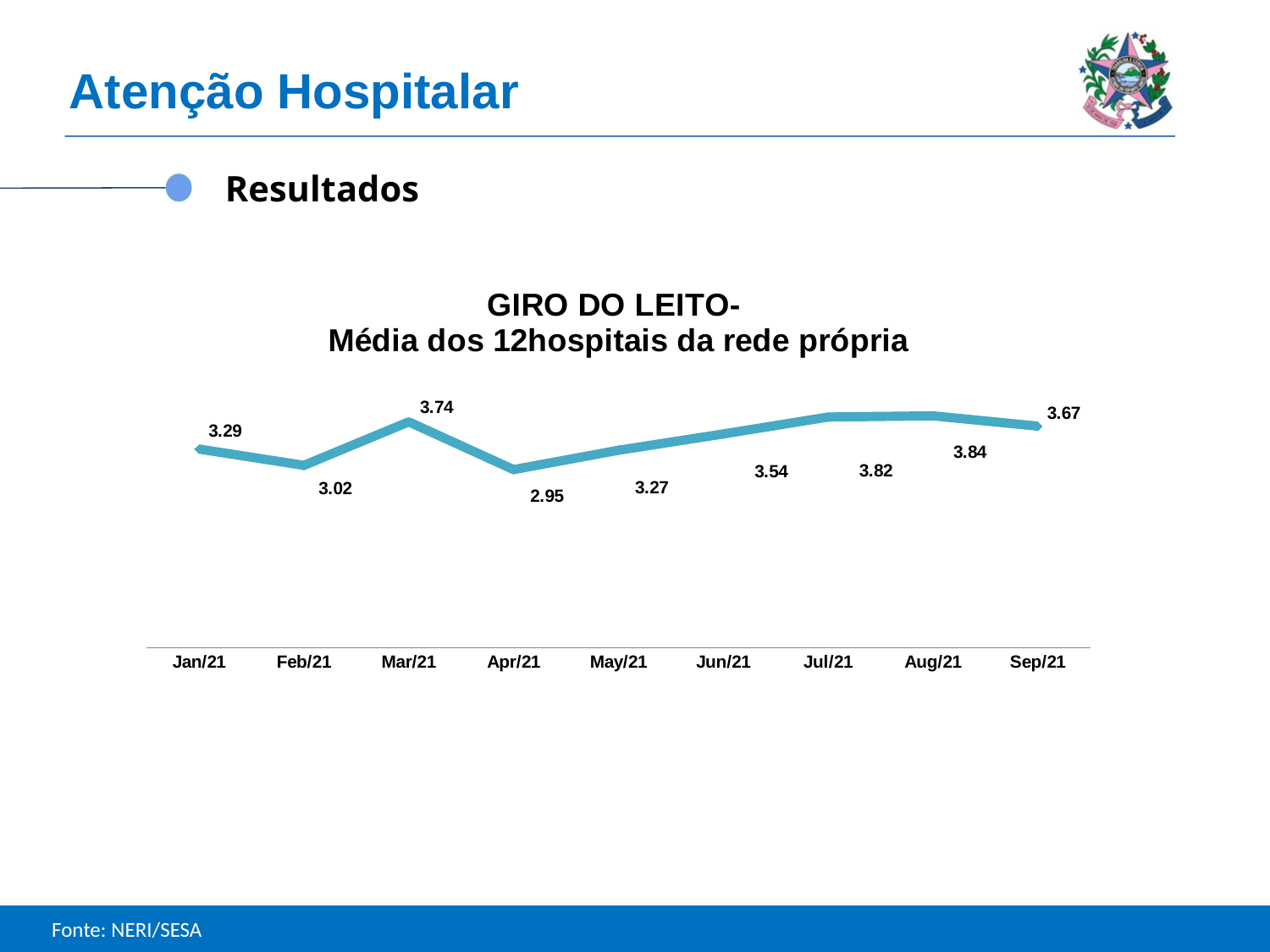
What is the value for Apr/21? 2.95 Which month has the lowest value? Apr/21 What is the value for Mar/21? 3.74 How many months are plotted on the chart? 9 Do the values rise or fall from Apr/21 to Aug/21? Rise What is the value for Jun/21? 3.54 What is the difference between the values for Mar/21 and Apr/21? 0.79 What kind of chart is shown? Line chart Which month has the highest value? Aug/21 What is the difference between the values for Sep/21 and Jan/21? 0.38 What is the value for Sep/21? 3.67 Which is larger, the value for Feb/21 or the value for May/21? May/21